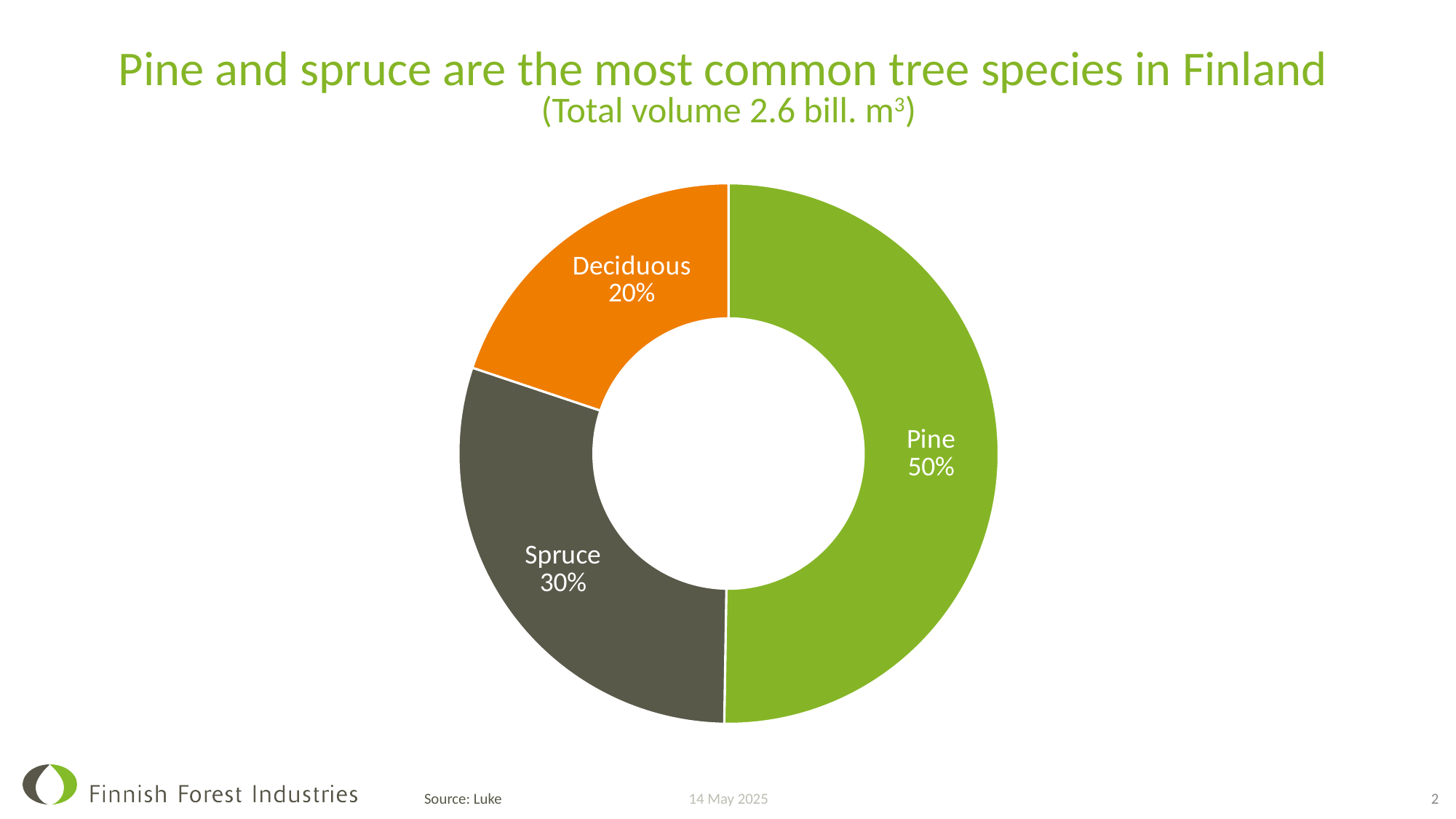
What kind of chart is shown on the slide? Pie chart (doughnut) What is the difference in percentage points between the Pine and Spruce shares? 20 What share of the total volume is Spruce? 30% What is the difference in percentage points between the Spruce and Deciduous shares? 10 What total volume is stated in the chart's subtitle? 2.6 bill. m³ How many tree species categories are shown in the chart? 3 What share of the total volume is Pine? 50% What colour is the Deciduous slice? Orange Which tree species has the smallest share of the total volume? Deciduous Which tree species has the largest share of the total volume? Pine Which has a larger share, Spruce or Deciduous? Spruce What share of the total volume is Deciduous? 20%